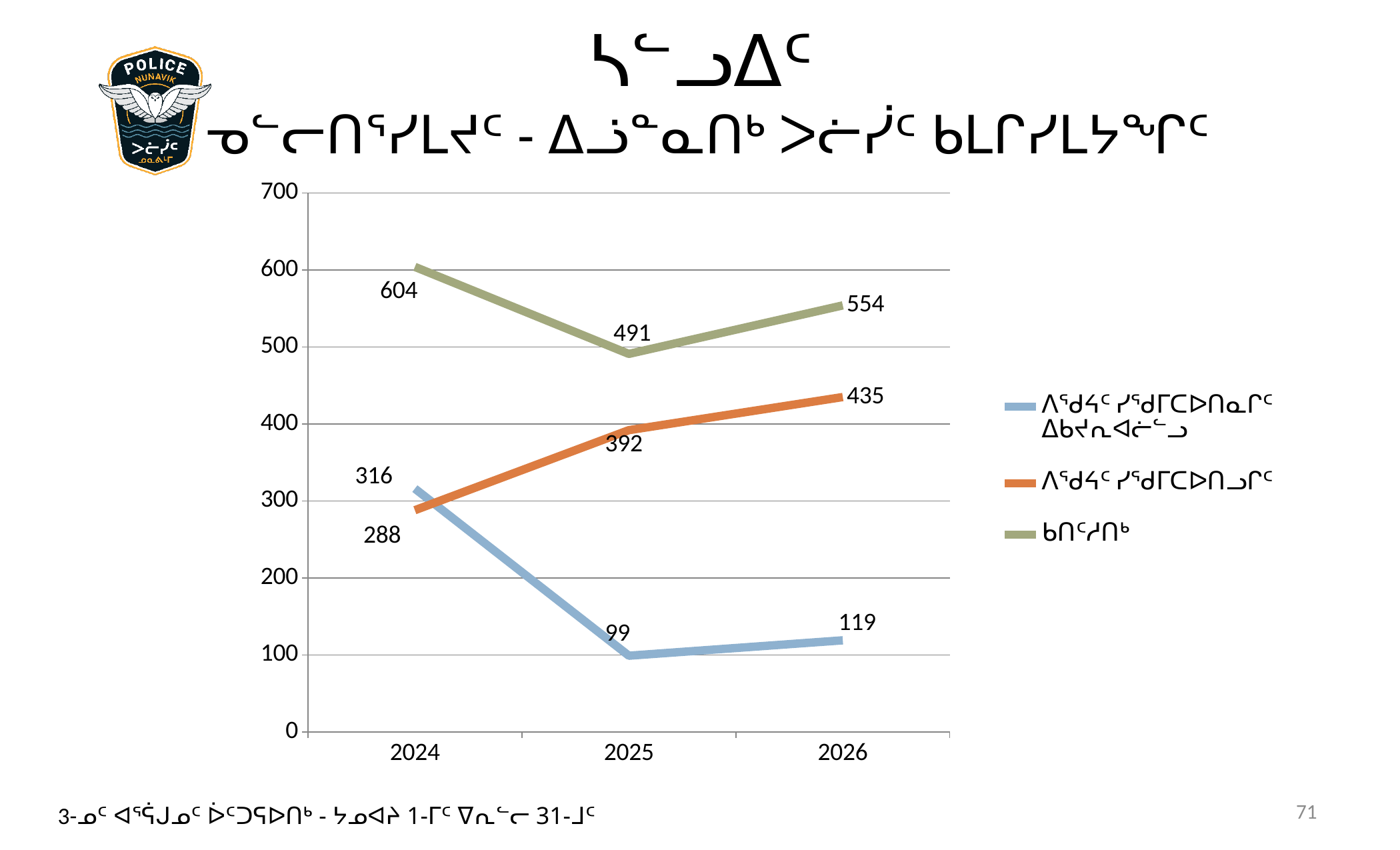
By how much does the green line drop from 2024 to 2025? 113 How much higher is the orange line in 2026 than in 2024? 147 What kind of chart is shown on the slide? line chart How many series does the legend list? 3 What is the value of the green line in 2024? 604 In which year does the blue line reach its lowest value? 2025 In which year does the green line reach its highest value? 2024 In 2024, which line has the larger value, the blue line or the orange line? the blue line How many years are shown on the x axis? 3 Is the value of the orange line in 2025 greater or less than 300? greater What is the value of the orange line in 2026? 435 What is the value of the blue line in 2025? 99